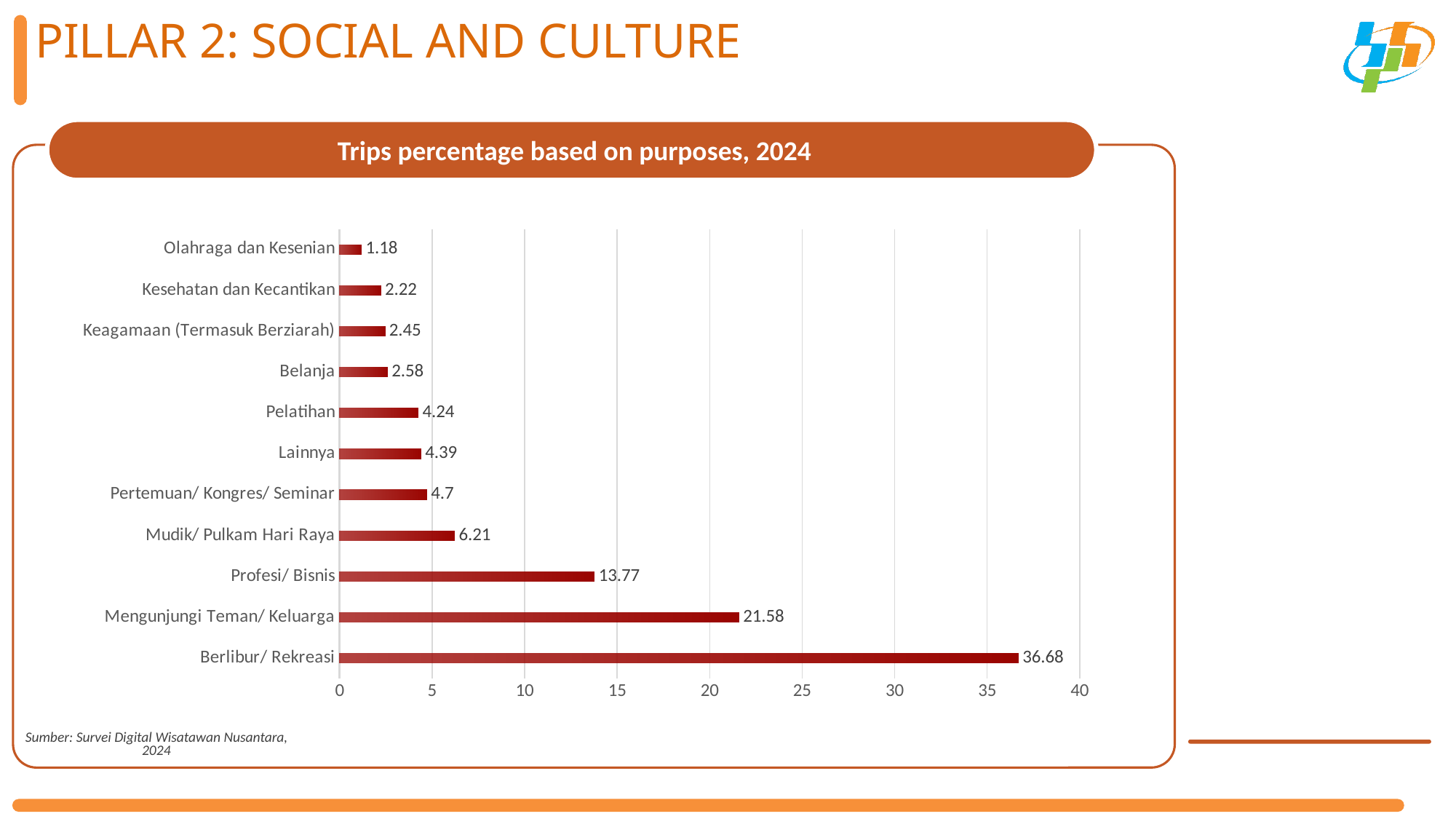
How many categories are shown in the chart? 11 Which category has the lowest value? Olahraga dan Kesenian What is the value for Berlibur/ Rekreasi? 36.68 What kind of chart is shown on the slide? Bar chart What is the difference between the values for Profesi/ Bisnis and Mudik/ Pulkam Hari Raya? 7.56 Which category has the highest value? Berlibur/ Rekreasi What is the value for Mudik/ Pulkam Hari Raya? 6.21 What is the value for Profesi/ Bisnis? 13.77 What is the value for Keagamaan (Termasuk Berziarah)? 2.45 What is the title of the chart? Trips percentage based on purposes, 2024 Which is larger, the value for Pelatihan or the value for Belanja? Pelatihan What is the difference between the values for Berlibur/ Rekreasi and Mengunjungi Teman/ Keluarga? 15.1